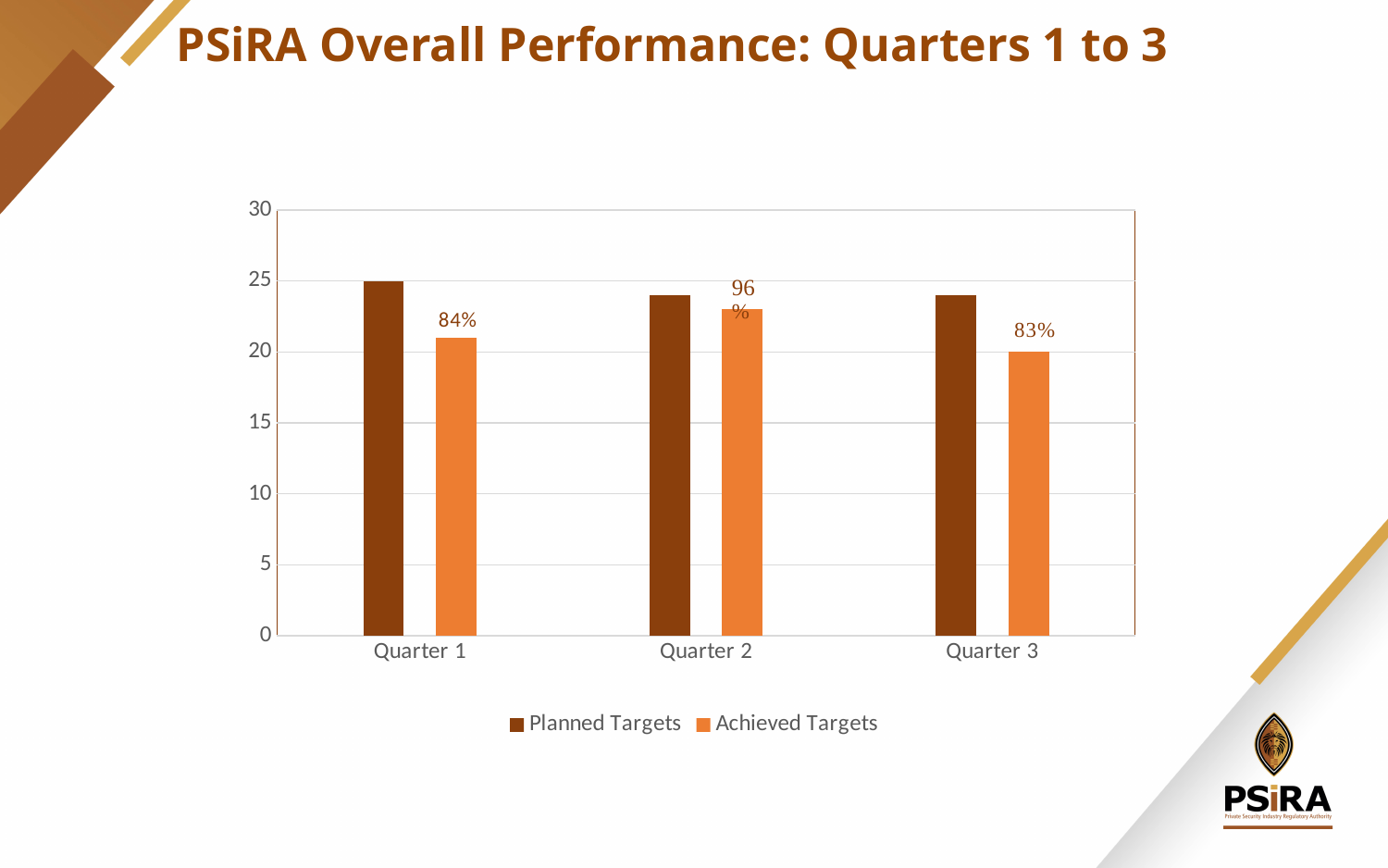
Which quarter has the highest achieved percentage label? Quarter 2 In Quarter 1, which is larger: Planned Targets or Achieved Targets? Planned Targets How many quarters are shown on the x axis? 3 Which quarter has the lowest achieved percentage label? Quarter 3 What kind of chart is shown on the slide? bar chart What percentage label is shown on the Achieved Targets bar for Quarter 3? 83% What is the title of the slide containing the chart? PSiRA Overall Performance: Quarters 1 to 3 Is the value for Planned Targets in Quarter 2 greater or less than 20? greater What percentage label is shown on the Achieved Targets bar for Quarter 2? 96% How many series does the legend list? 2 What is the difference between the achieved percentage labels for Quarter 2 and Quarter 3? 13% What percentage label is shown on the Achieved Targets bar for Quarter 1? 84%